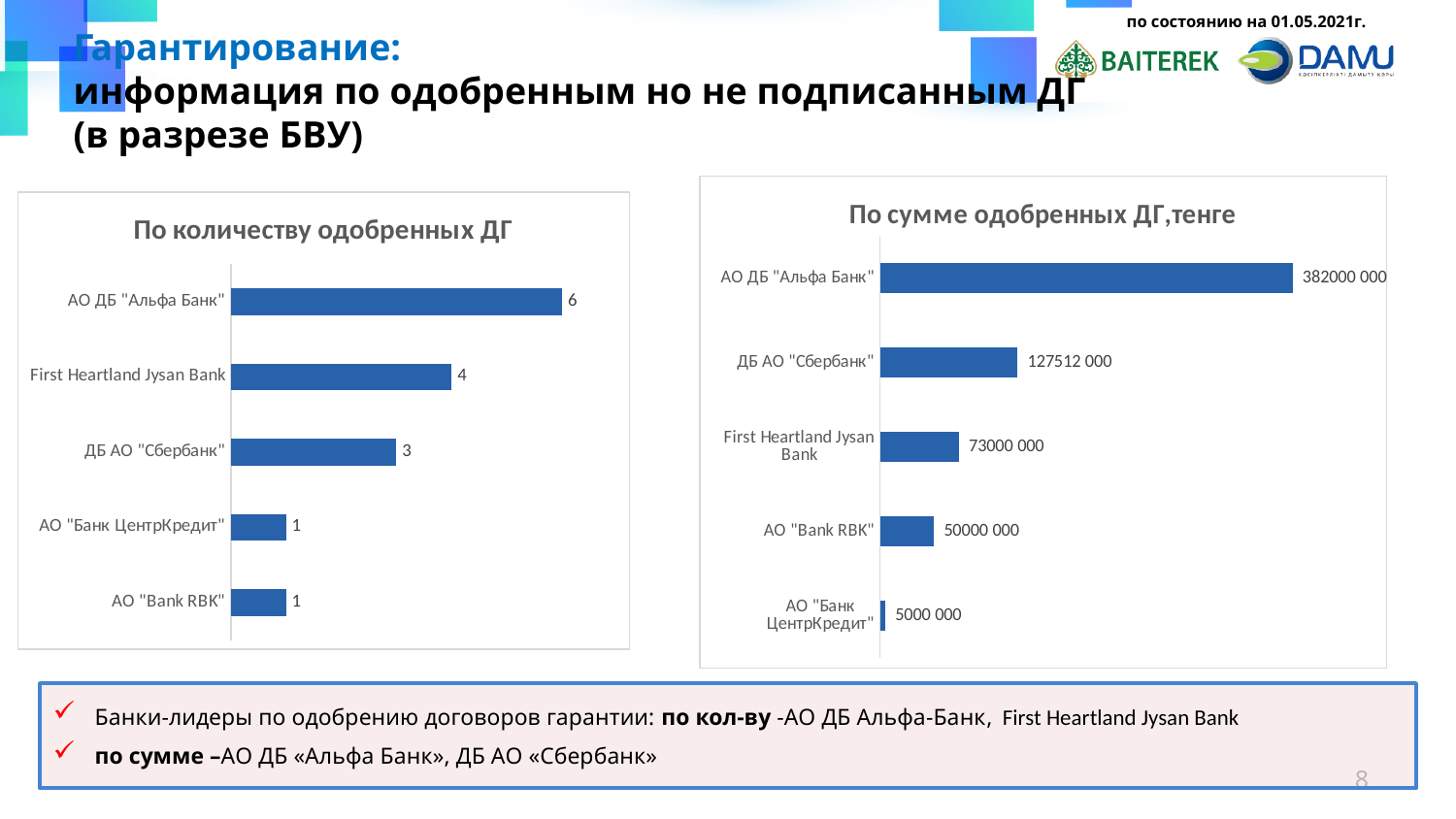
In the chart "По сумме одобренных ДГ,тенге", what is the value for ДБ АО "Сбербанк"? 127512 000 In the chart "По сумме одобренных ДГ,тенге", which is larger: First Heartland Jysan Bank or АО "Bank RBK"? First Heartland Jysan Bank In the chart "По сумме одобренных ДГ,тенге", what is the value for АО "Bank RBK"? 50000 000 In the chart "По количеству одобренных ДГ", how many banks are shown? 5 In the chart "По сумме одобренных ДГ,тенге", what is the difference between АО ДБ "Альфа Банк" and ДБ АО "Сбербанк"? 254488 000 In the chart "По количеству одобренных ДГ", what is the value for First Heartland Jysan Bank? 4 In the chart "По количеству одобренных ДГ", which bank has the highest value? АО ДБ "Альфа Банк" What type of chart is "По сумме одобренных ДГ,тенге"? Bar chart In the chart "По количеству одобренных ДГ", what is the difference between АО ДБ "Альфа Банк" and ДБ АО "Сбербанк"? 3 In the chart "По сумме одобренных ДГ,тенге", which bank has the lowest value? АО "Банк ЦентрКредит" In the chart "По количеству одобренных ДГ", what is the value for АО ДБ "Альфа Банк"? 6 What is the title of the chart on the left side of the slide? По количеству одобренных ДГ